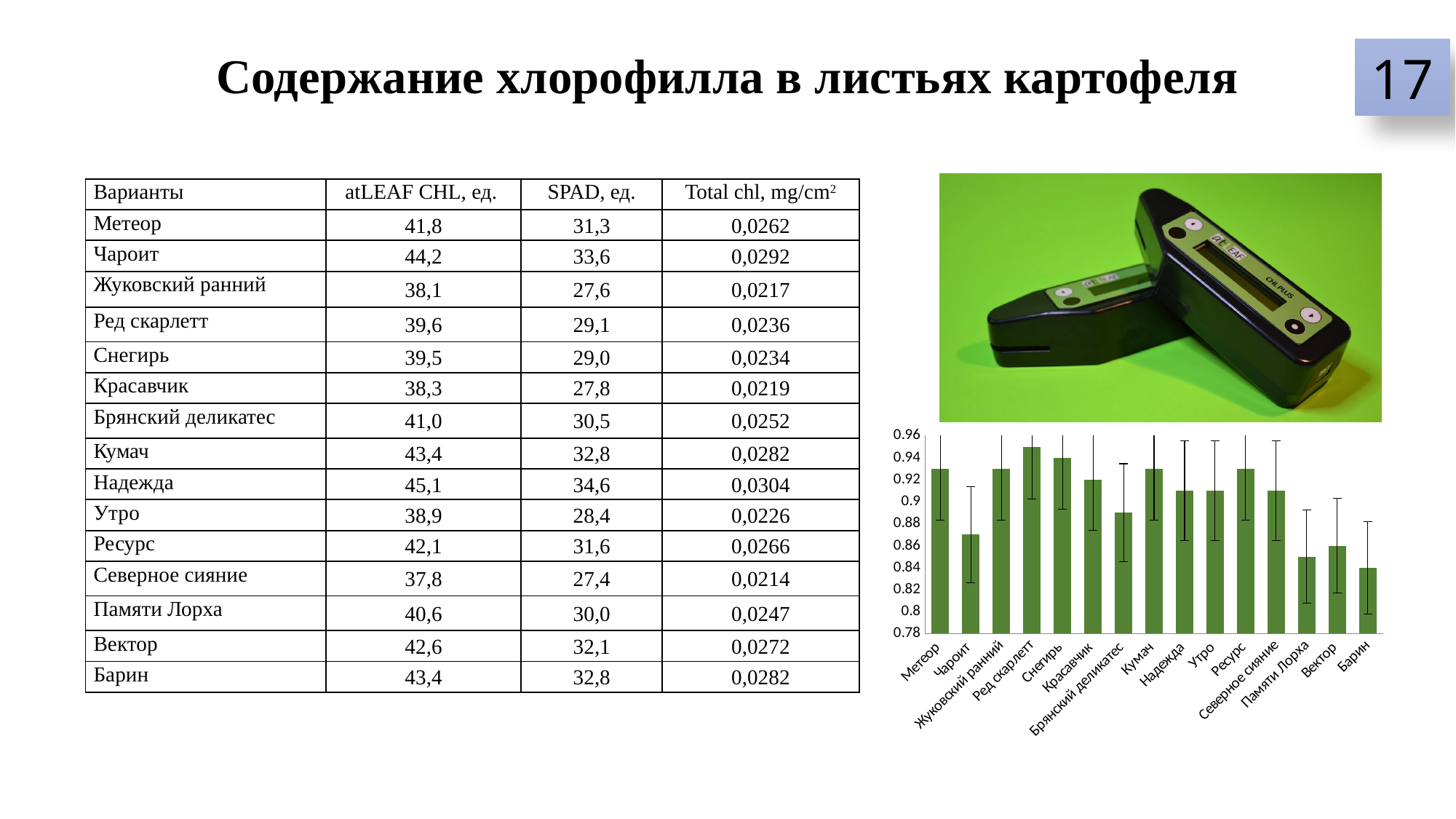
On the bar chart, which has the larger value, Снегирь or Барин? Снегирь How many categories (potato varieties) are plotted on the bar chart? 15 On the bar chart, is the value for Ред скарлетт greater or less than 0.92? greater On the bar chart, is the value for Барин greater or less than 0.86? less On the bar chart, which has the larger value, Метеор or Чароит? Метеор What colour are the bars in the bar chart? green What kind of chart is shown on the slide? bar chart On the bar chart, is the value for Вектор greater or less than 0.9? less What is the lowest value shown on the y axis of the bar chart? 0.78